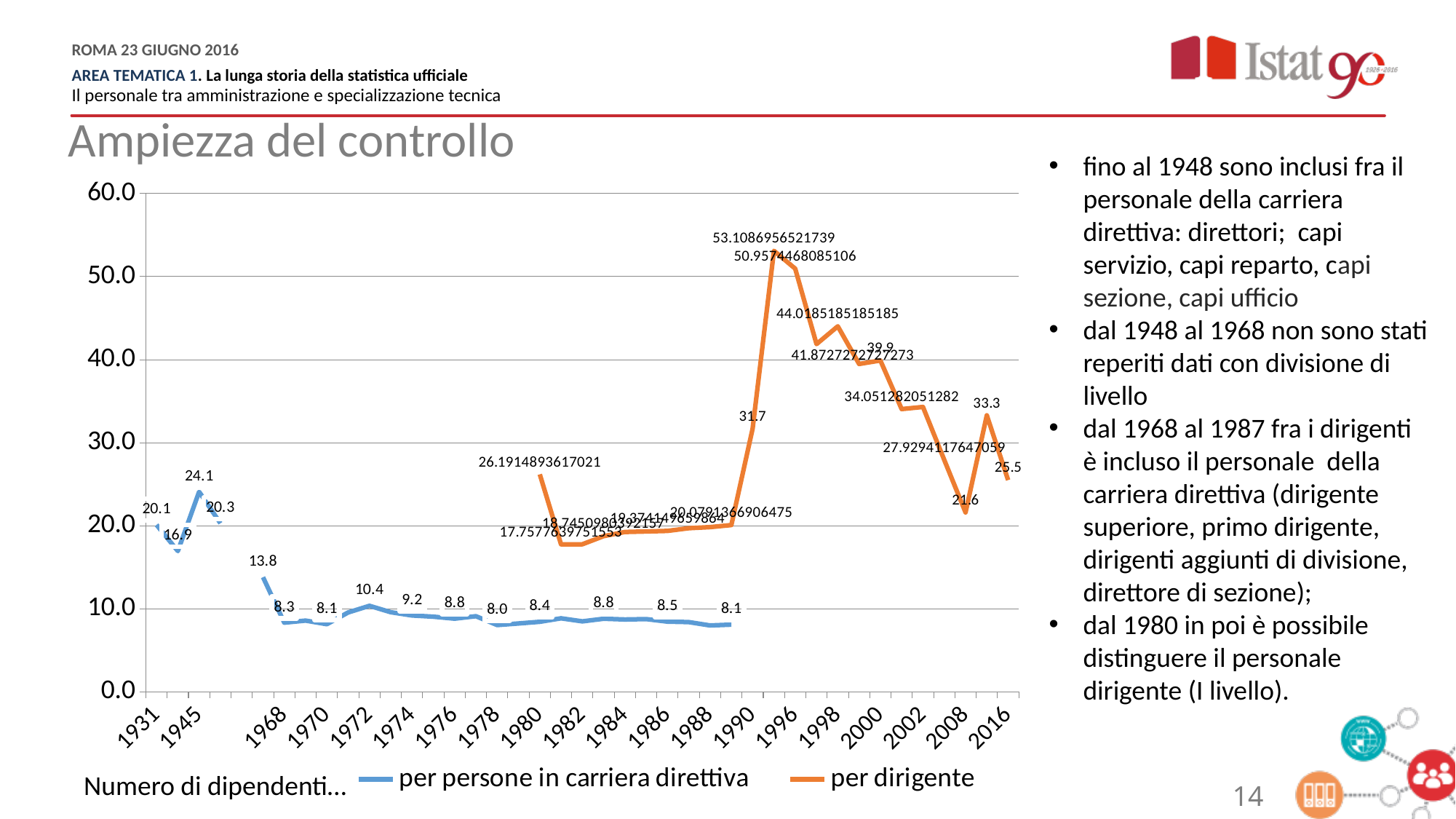
What kind of chart is shown on the slide? line chart How many series does the chart legend list? 2 What are the two series named in the legend? per persone in carriera direttiva; per dirigente What is the value of the 'per dirigente' series in 2016? 25.5 What is the title of the chart? Ampiezza del controllo What is the difference between the highest and lowest values of the 'per persone in carriera direttiva' series? 16.1 What is the highest value reached by the 'per dirigente' series? 53.1086956521739 Is the peak value of the 'per dirigente' series greater or less than 50? greater What is the lowest value of the 'per dirigente' series? 17.7577639751553 What is the value of the 'per persone in carriera direttiva' series in 1931? 20.1 What is the lowest value of the 'per persone in carriera direttiva' series? 8.0 What is the highest value of the 'per persone in carriera direttiva' series? 24.1